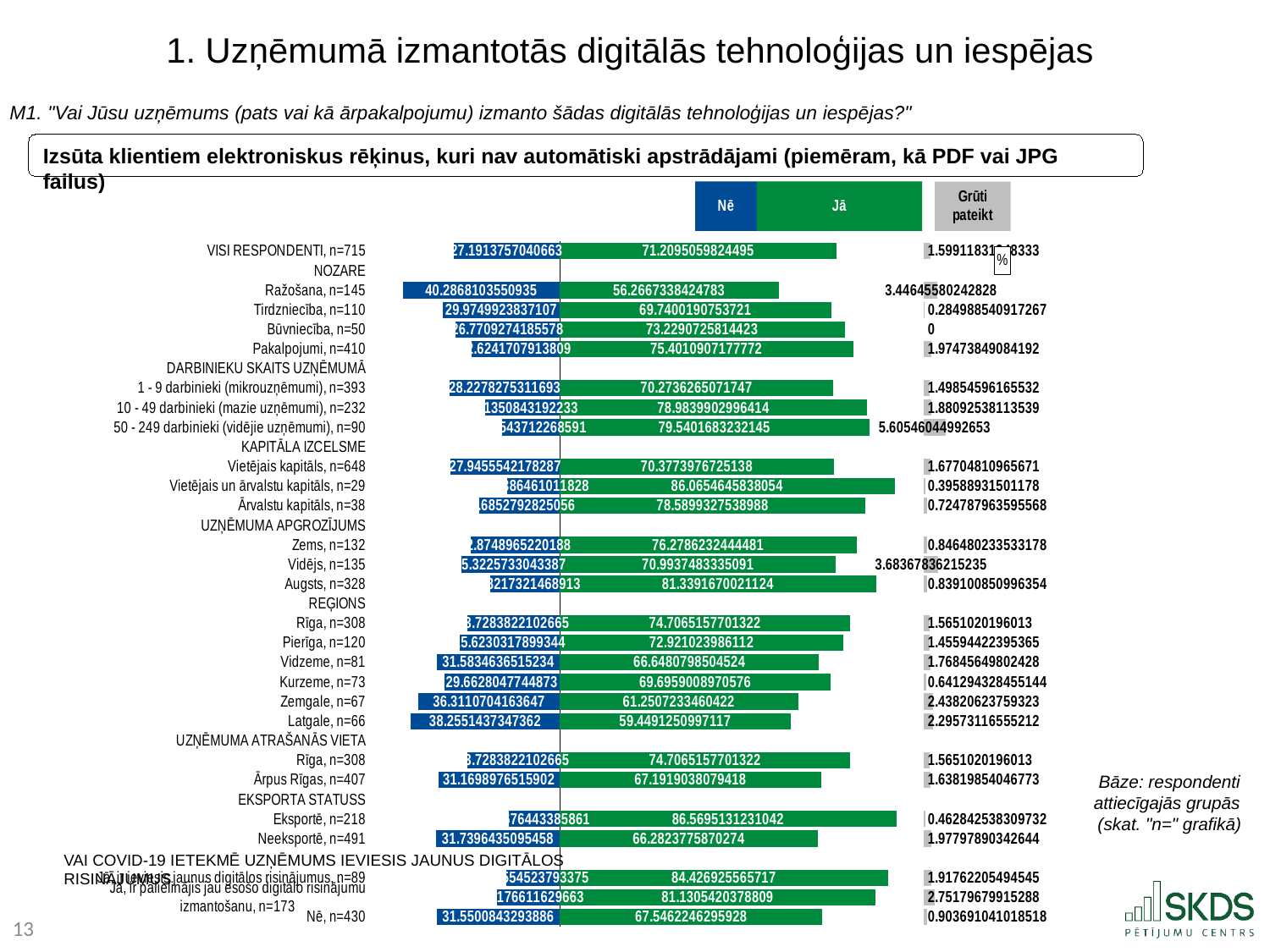
What colour represents the "Jā" series in the chart? Green How many series does the chart legend list? 3 What is the total of the stacked bar for Ražošana, n=145 (Nē + Jā + Grūti pateikt)? 100 What is the difference between the "Jā" values for Zemgale, n=67 and Latgale, n=66? 1.8015982463305 Which has the larger "Nē" value, Zemgale, n=67 or Latgale, n=66? Latgale, n=66 What is the "Nē" value for Latgale, n=66? 38.2551437347362 Which category has the lowest "Jā" value? Ražošana, n=145 Which category has the highest "Nē" value? Ražošana, n=145 What is the "Grūti pateikt" value for 50 - 249 darbinieki (vidējie uzņēmumi), n=90? 5.60546044992653 What is the "Jā" value for Ražošana, n=145? 56.2667338424783 What is the "Jā" value for Eksportē, n=218? 86.5695131231042 What kind of chart is shown on the slide? Stacked bar chart